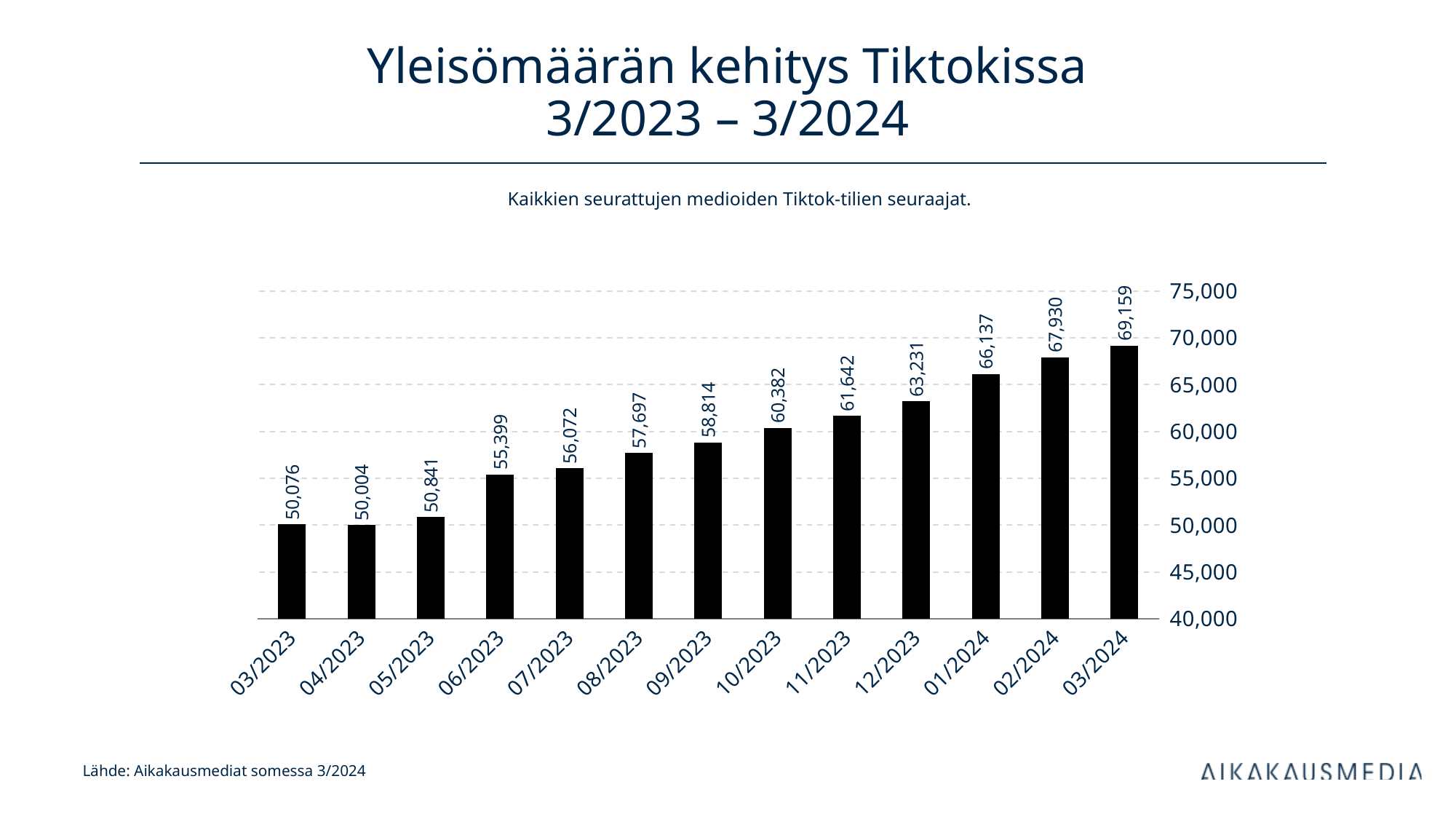
Which month has the highest value? 03/2024 What is the difference between the values for 03/2024 and 03/2023? 19,083 What is the value for 03/2024? 69,159 What is the value for 03/2023? 50,076 Which month has the lowest value? 04/2023 Which is larger, the value for 06/2023 or the value for 12/2023? 12/2023 How many months are shown on the x axis? 13 Do the values rise or fall from 03/2023 to 03/2024? rise What kind of chart is shown on the slide? bar chart What is the difference between the values for 02/2024 and 01/2024? 1,793 What is the value for 09/2023? 58,814 Is the value for 11/2023 greater or less than 60,000? greater